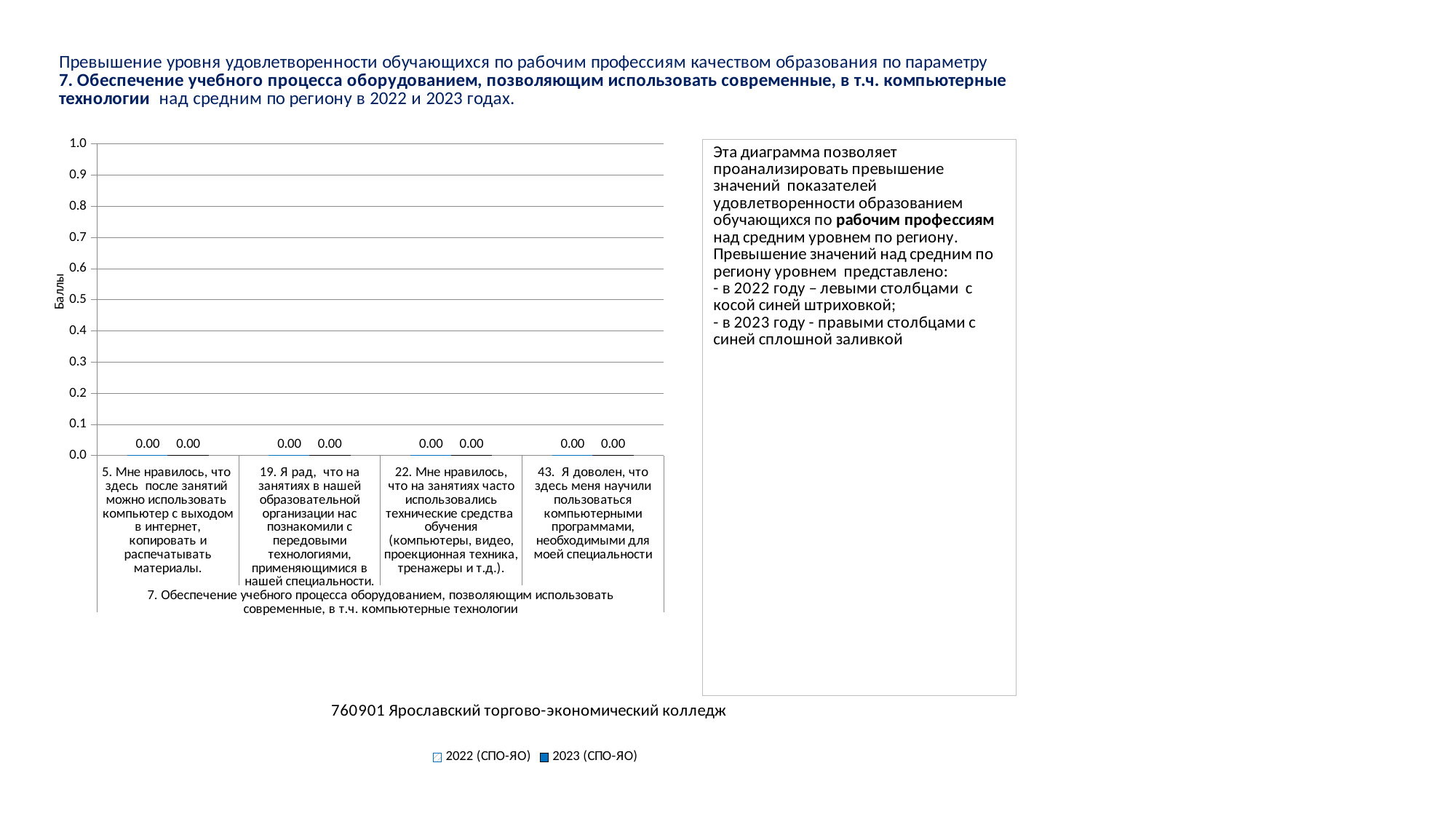
What is the difference between the 2022 (СПО-ЯО) and 2023 (СПО-ЯО) values for category 5? 0.00 What is the highest value shown on the vertical axis of the chart? 1.0 Is the value for 2023 (СПО-ЯО) for category 22 greater or less than 0.1? less How many series does the chart legend list? 2 What is the label of the vertical axis of the chart? Баллы What kind of chart is shown on the slide? bar chart What is the value for 2022 (СПО-ЯО) for category 5 (Мне нравилось, что здесь после занятий можно использовать компьютер с выходом в интернет...)? 0.00 What is the value for 2022 (СПО-ЯО) for category 22 (Мне нравилось, что на занятиях часто использовались технические средства обучения)? 0.00 What are the two series named in the chart legend? 2022 (СПО-ЯО) and 2023 (СПО-ЯО) How many categories are shown on the x axis of the chart? 4 What is the value for 2023 (СПО-ЯО) for category 19 (Я рад, что на занятиях в нашей образовательной организации нас познакомили с передовыми технологиями)? 0.00 What is the value for 2023 (СПО-ЯО) for category 43 (Я доволен, что здесь меня научили пользоваться компьютерными программами...)? 0.00